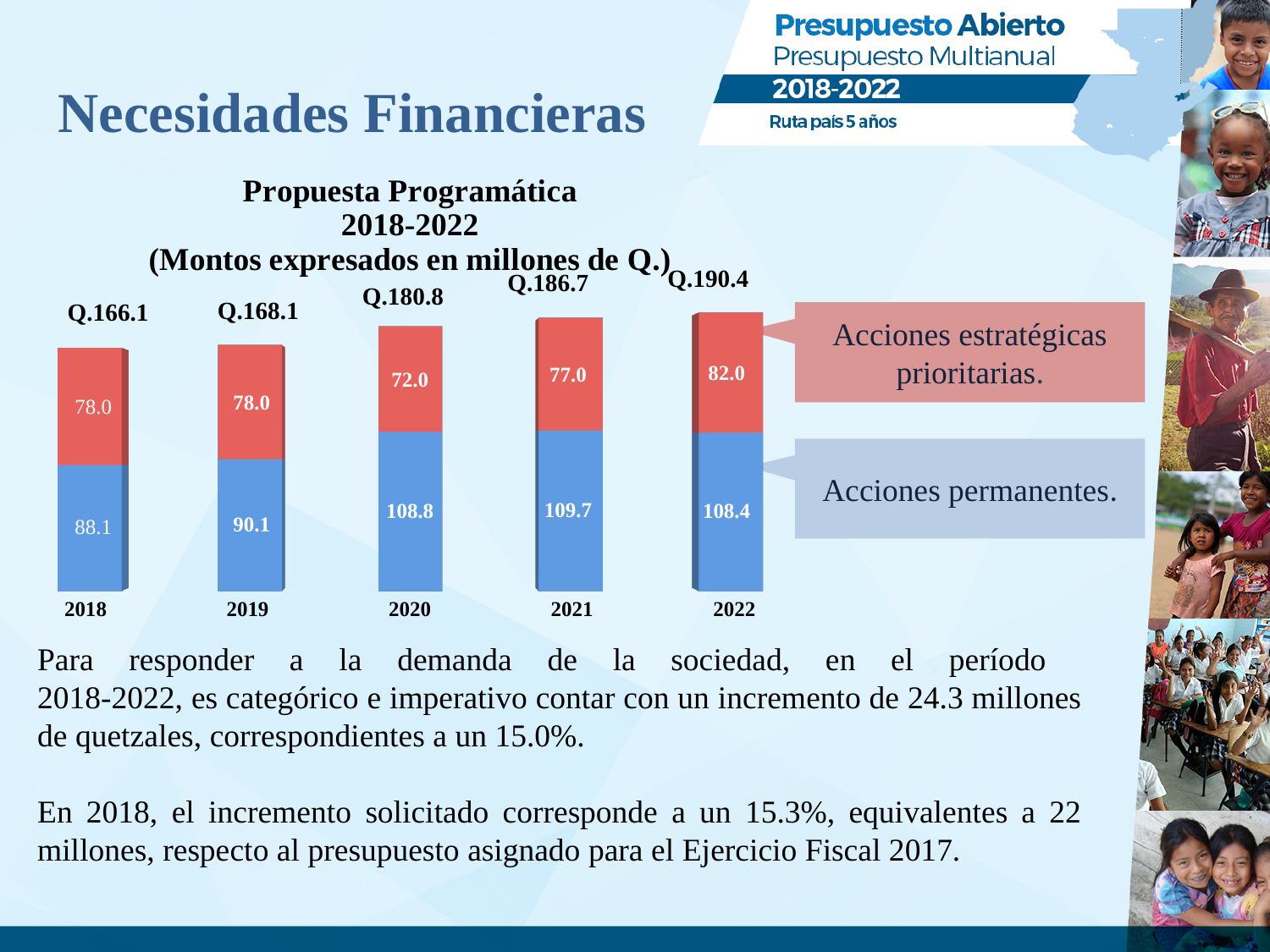
What kind of chart is shown on the slide? Stacked bar chart How many series are stacked in each bar of the chart? 2 Which year has the highest total in the chart? 2022 What is the total shown above the stacked bar for 2021? Q.186.7 Which is larger in 2021: Acciones permanentes or Acciones estratégicas prioritarias? Acciones permanentes What is the value for Acciones permanentes in 2020? 108.8 What is the difference between the Acciones permanentes values for 2019 and 2018? 2.0 In which year is the value for Acciones estratégicas prioritarias lowest? 2020 How many years are shown on the x axis of the chart? 5 Do the total values rise or fall from 2018 to 2022? Rise Which year has the lowest total in the chart? 2018 What is the value for Acciones estratégicas prioritarias in 2022? 82.0